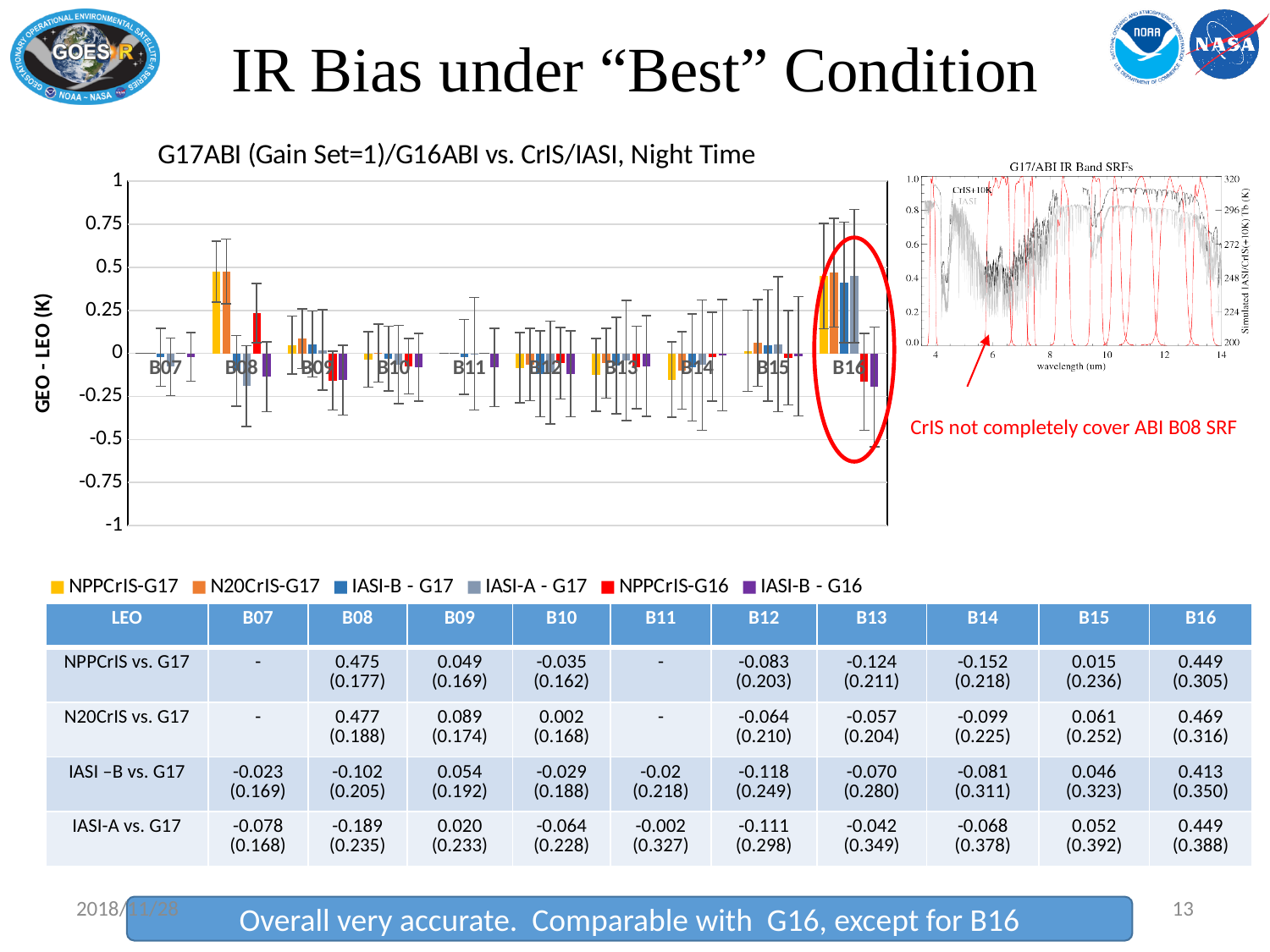
How many series does the legend of the main bar chart list? 6 What is the y-axis label of the main bar chart? GEO - LEO (K) What kind of chart is the main chart titled "G17ABI (Gain Set=1)/G16ABI vs. CrIS/IASI, Night Time"? bar chart According to the table under the main bar chart, which band has the lowest NPPCrIS vs. G17 value? B14 According to the table under the main bar chart, which band has the largest NPPCrIS vs. G17 value? B08 For B16 in the main bar chart, which is larger: the N20CrIS vs. G17 value or the IASI-B vs. G17 value? N20CrIS vs. G17 For B07 in the main bar chart, which is larger: the IASI-B vs. G17 value or the IASI-A vs. G17 value? IASI-B vs. G17 In the main bar chart, is the NPPCrIS-G16 value for B08 greater or less than 0.5? less In the main bar chart, what is the difference between the N20CrIS vs. G17 values for B08 and B09? 0.388 In the main bar chart, what is the NPPCrIS vs. G17 bias value for B08, as given in the table? 0.475 How many bands (categories) are shown along the x axis of the main bar chart? 10 In the main bar chart, what is the IASI-A vs. G17 bias value for B11, as given in the table? -0.002